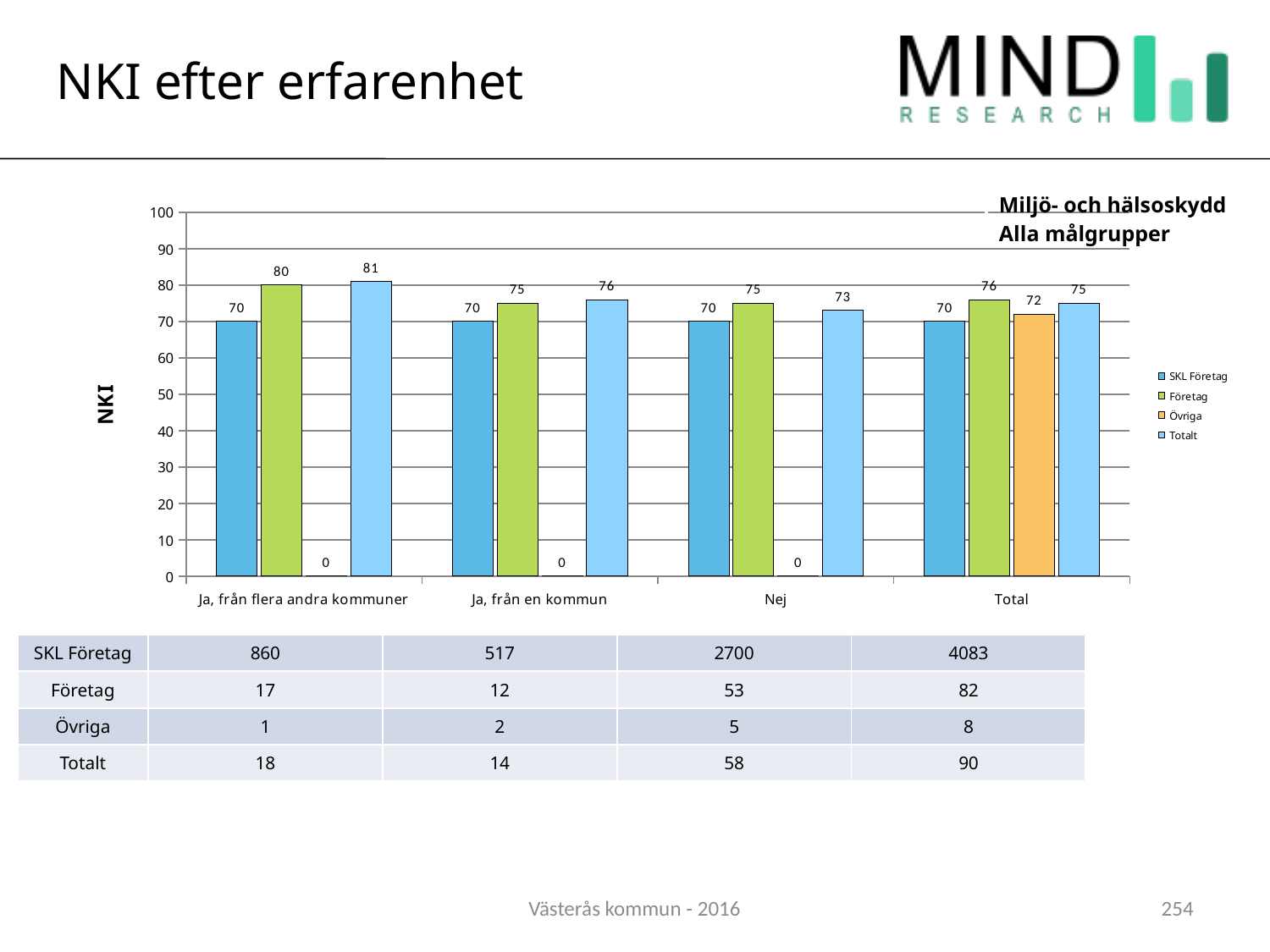
How many categories are shown on the x axis of the chart? 4 Which is larger in the category "Total": the Företag value or the Totalt value? Företag What is the value for Övriga in the category "Total"? 72 Which category has the lowest value for Totalt? Nej What is the difference between the Företag value and the SKL Företag value in the category "Ja, från flera andra kommuner"? 10 What is the label of the y axis of the chart? NKI Which category has the highest value for Totalt? Ja, från flera andra kommuner What kind of chart is shown on the slide? Bar chart What is the value for Totalt in the category "Nej"? 73 What is the value for Företag in the category "Ja, från flera andra kommuner"? 80 How many series does the chart legend list? 4 What is the value for SKL Företag in the category "Ja, från en kommun"? 70